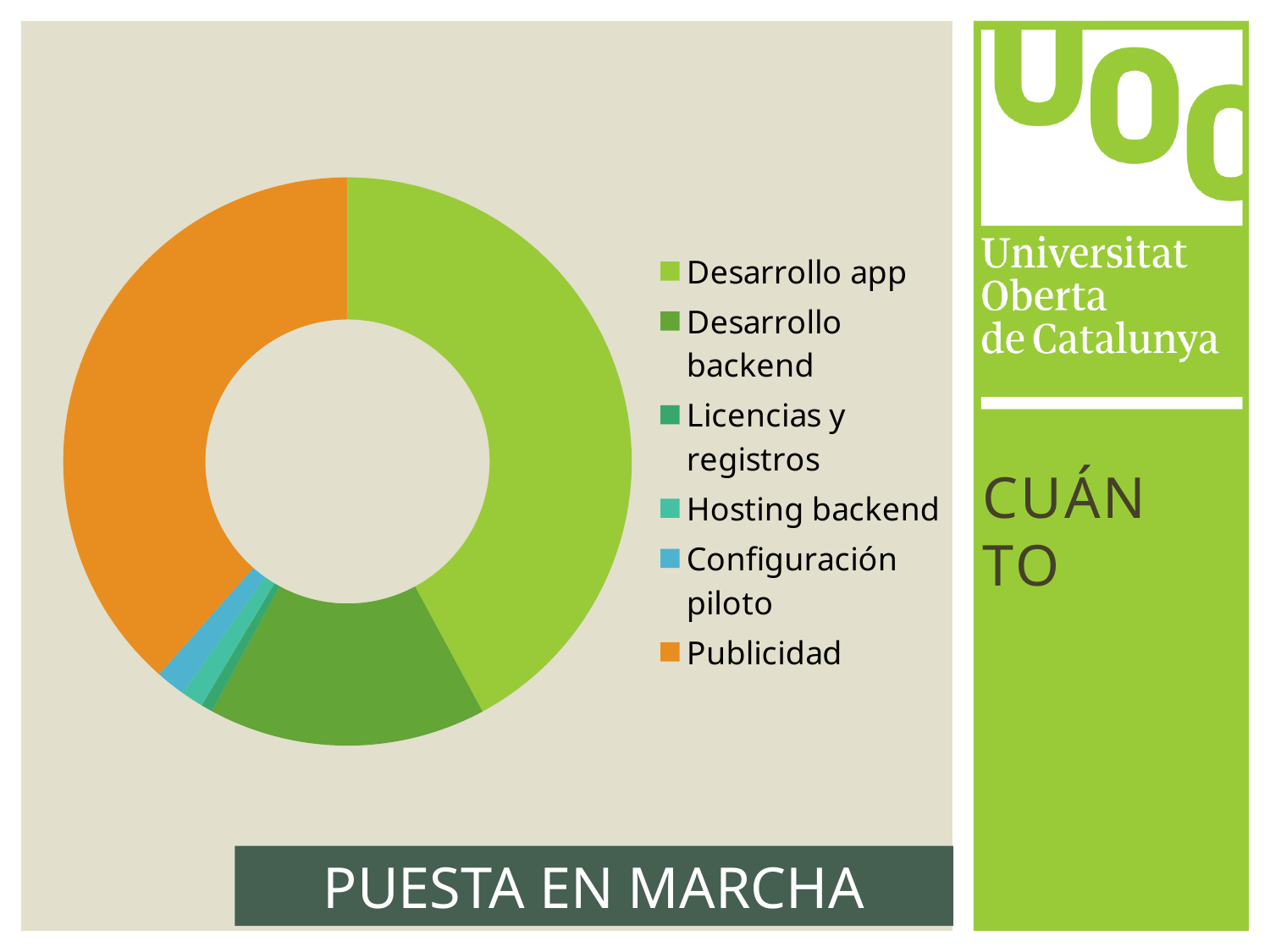
Which slice is larger, Publicidad or Configuración piloto? Publicidad How many categories does the legend of the chart list? 6 Which slice is larger, Publicidad or Desarrollo backend? Publicidad Which slice is larger, Desarrollo app or Desarrollo backend? Desarrollo app Which category has the largest slice in the chart? Desarrollo app What is the title shown in the banner below the chart? PUESTA EN MARCHA What kind of chart is shown on the slide? Doughnut (pie) chart What colour is the Publicidad slice in the chart? Orange